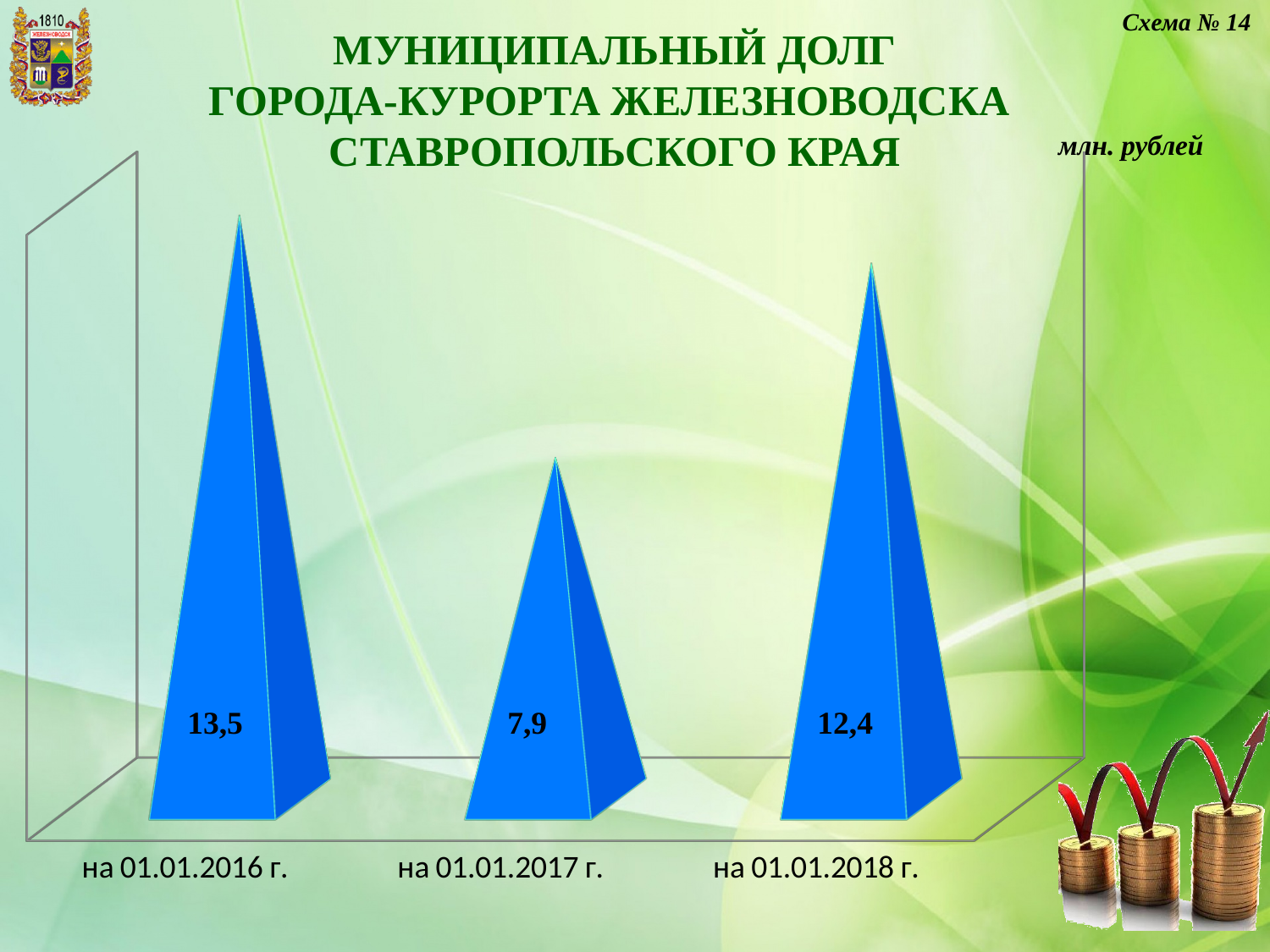
What is the municipal debt value shown for на 01.01.2016 г.? 13,5 What is the municipal debt value shown for на 01.01.2017 г.? 7,9 What is the difference between the values for на 01.01.2016 г. and на 01.01.2017 г.? 5,6 What is the difference between the values for на 01.01.2018 г. and на 01.01.2017 г.? 4,5 What kind of chart is shown on the slide? bar chart Which is larger, the value for на 01.01.2016 г. or the value for на 01.01.2018 г.? на 01.01.2016 г. In what units are the values on the chart expressed? млн. рублей How many dates (categories) are shown on the chart? 3 What is the title of the chart? МУНИЦИПАЛЬНЫЙ ДОЛГ ГОРОДА-КУРОРТА ЖЕЛЕЗНОВОДСКА СТАВРОПОЛЬСКОГО КРАЯ Which date has the lowest municipal debt value? на 01.01.2017 г. What is the municipal debt value shown for на 01.01.2018 г.? 12,4 Which date has the highest municipal debt value? на 01.01.2016 г.